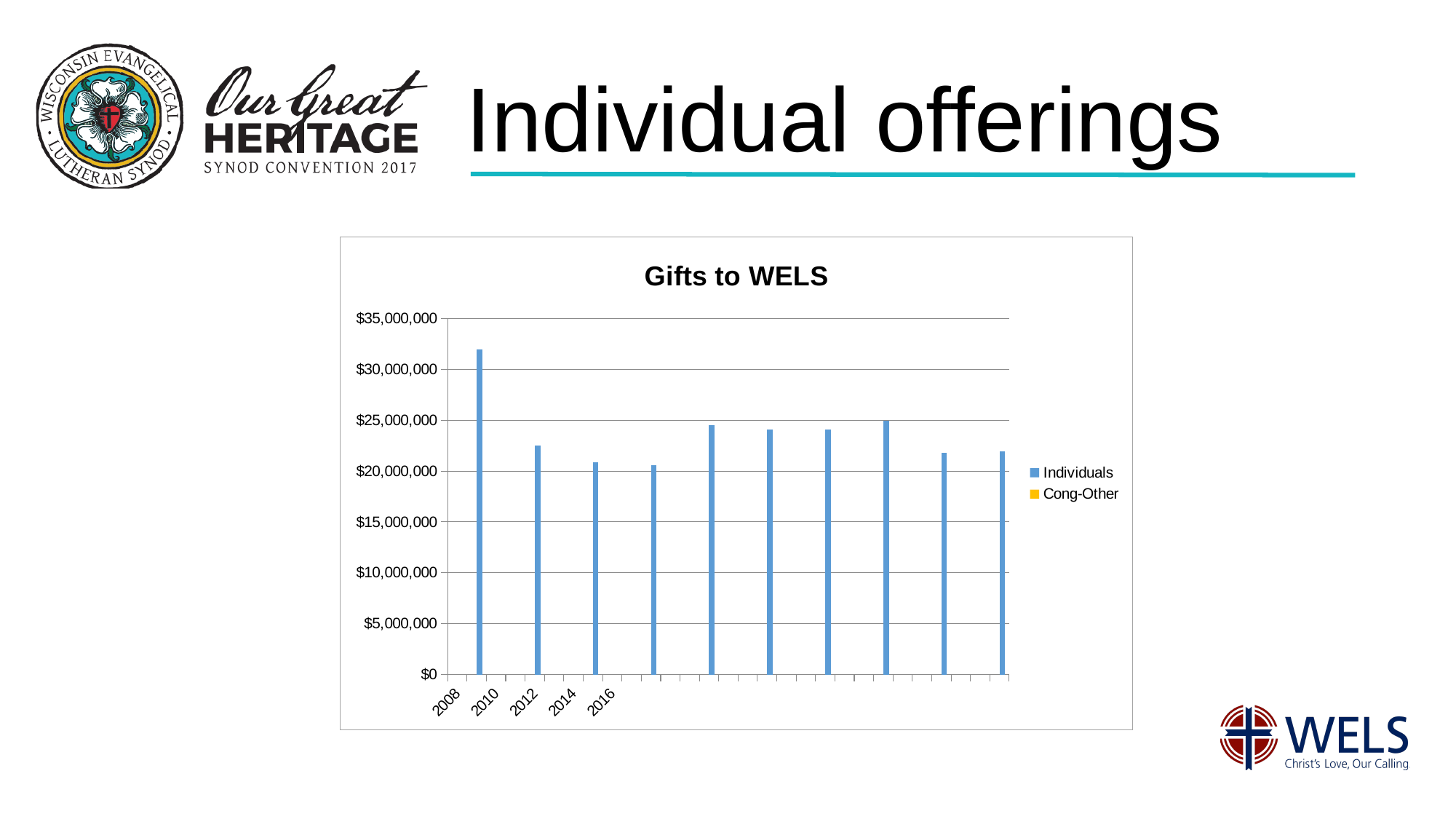
Is the value of the first (leftmost) bar greater or less than $30,000,000? greater How many bars are plotted in the chart? 10 Which is larger, the first bar or the last bar? The first bar Which bar is the highest in the chart? The first (leftmost) bar What are the two series named in the legend? Individuals and Cong-Other What kind of chart is shown on the slide? Bar chart How many series does the legend list? 2 Is the value of the second bar greater or less than $25,000,000? less What is the title of the chart? Gifts to WELS Does the value rise or fall from the first bar to the second bar? Falls Is the value of the last (rightmost) bar greater or less than $20,000,000? greater